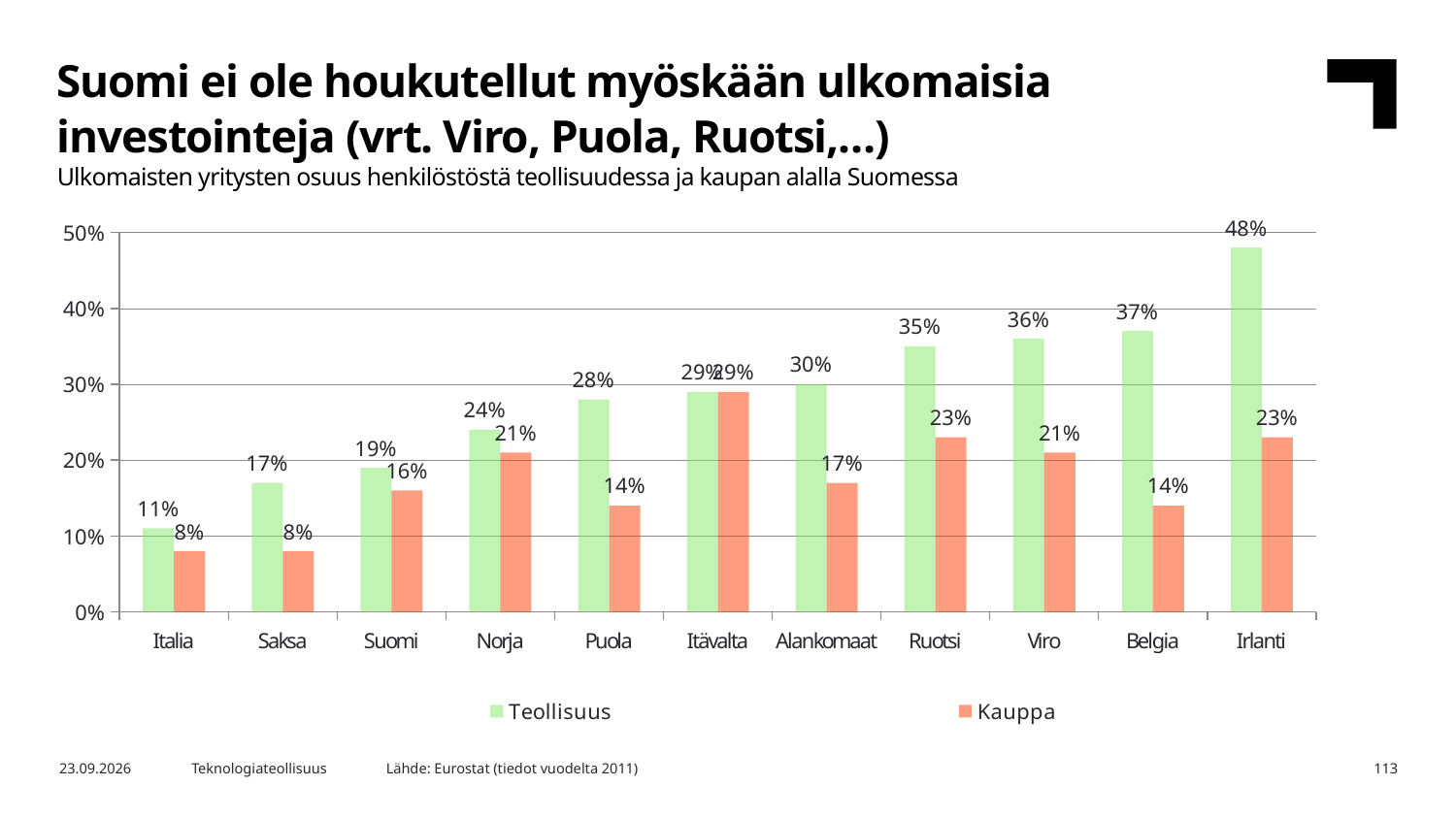
Which is larger, the Kauppa value for Ruotsi or the Kauppa value for Puola? Ruotsi Which country has the highest Kauppa value? Itävalta How many series does the legend list? 2 What is the Teollisuus value for Irlanti? 48% Do the Teollisuus values rise or fall from Italia to Irlanti along the x axis? Rise What is the Teollisuus value for Suomi? 19% Which country has the lowest Teollisuus value? Italia What is the difference between the Teollisuus values for Belgia and Suomi? 18 percentage points What kind of chart is shown on the slide? Bar chart Which country has the highest Teollisuus value? Irlanti How many countries are shown on the x axis? 11 What is the Kauppa value for Viro? 21%